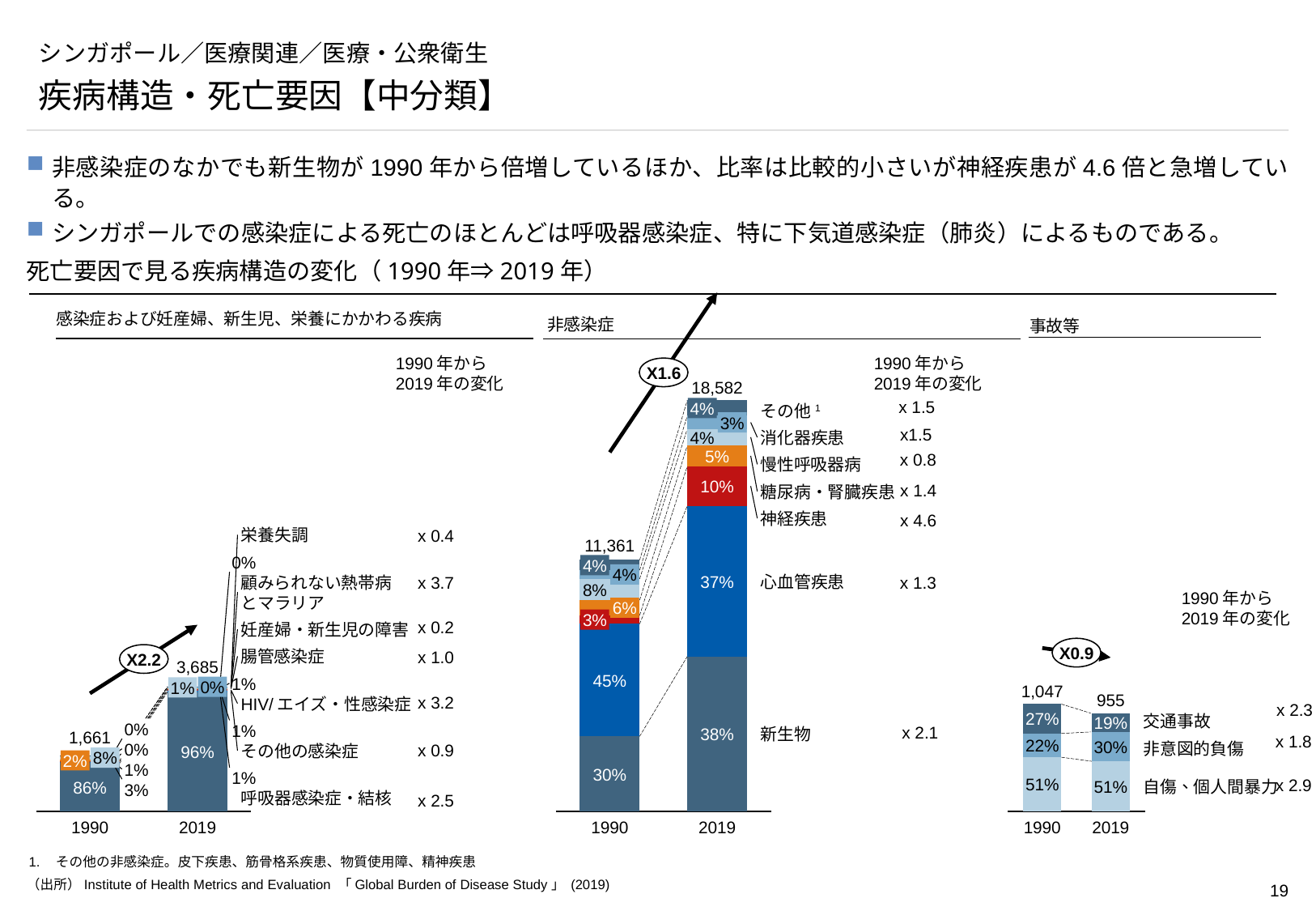
In the 感染症および妊産婦、新生児、栄養にかかわる疾病 chart, what is the total shown for 1990? 1,661 In the 非感染症 chart, what is the change from 1990 to 2019 shown for 神経疾患? x 4.6 In the 非感染症 chart, is the share of 新生物 larger in 1990 or in 2019? 2019 How many bars are shown in the 事故等 chart? 2 In the 事故等 chart, what is the difference between the 1990 total and the 2019 total? 92 In the 感染症および妊産婦、新生児、栄養にかかわる疾病 chart, what percentage does 呼吸器感染症・結核 account for in 2019? 96% What multiplier label is shown above the bars in the 事故等 chart? X0.9 In the 非感染症 chart, which category has the largest share in 2019? 新生物 In the 非感染症 chart, what is the total number of deaths shown for 2019? 18,582 What kind of chart is used in the 非感染症 section? Stacked bar chart In the 非感染症 chart, what percentage does 心血管疾患 account for in 1990? 45% In the 事故等 chart, what percentage does 交通事故 account for in 2019? 19%